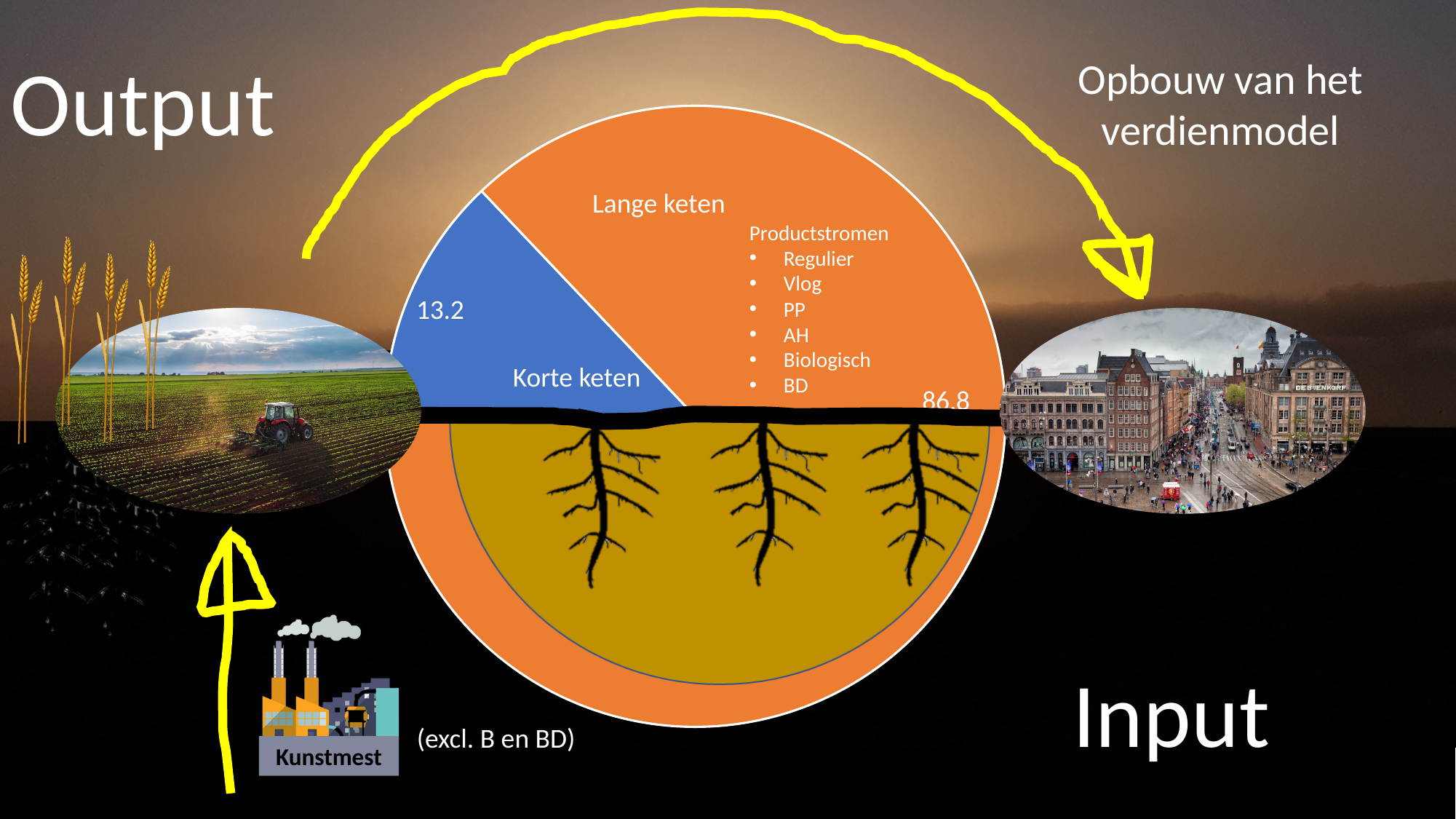
How many slices does the pie chart have? 2 What is the value shown for the Korte keten slice? 13.2 Which slice of the pie chart is the largest? Lange keten Which slice of the pie chart is the smallest? Korte keten What kind of chart is shown in the centre of the slide? pie chart What colour is the Korte keten slice? blue What is the value shown for the Lange keten slice? 86.8 What is the total of the two slice values in the pie chart? 100 What colour is the Lange keten slice? orange Which is larger, Korte keten or Lange keten? Lange keten What is the difference between the Lange keten value and the Korte keten value? 73.6